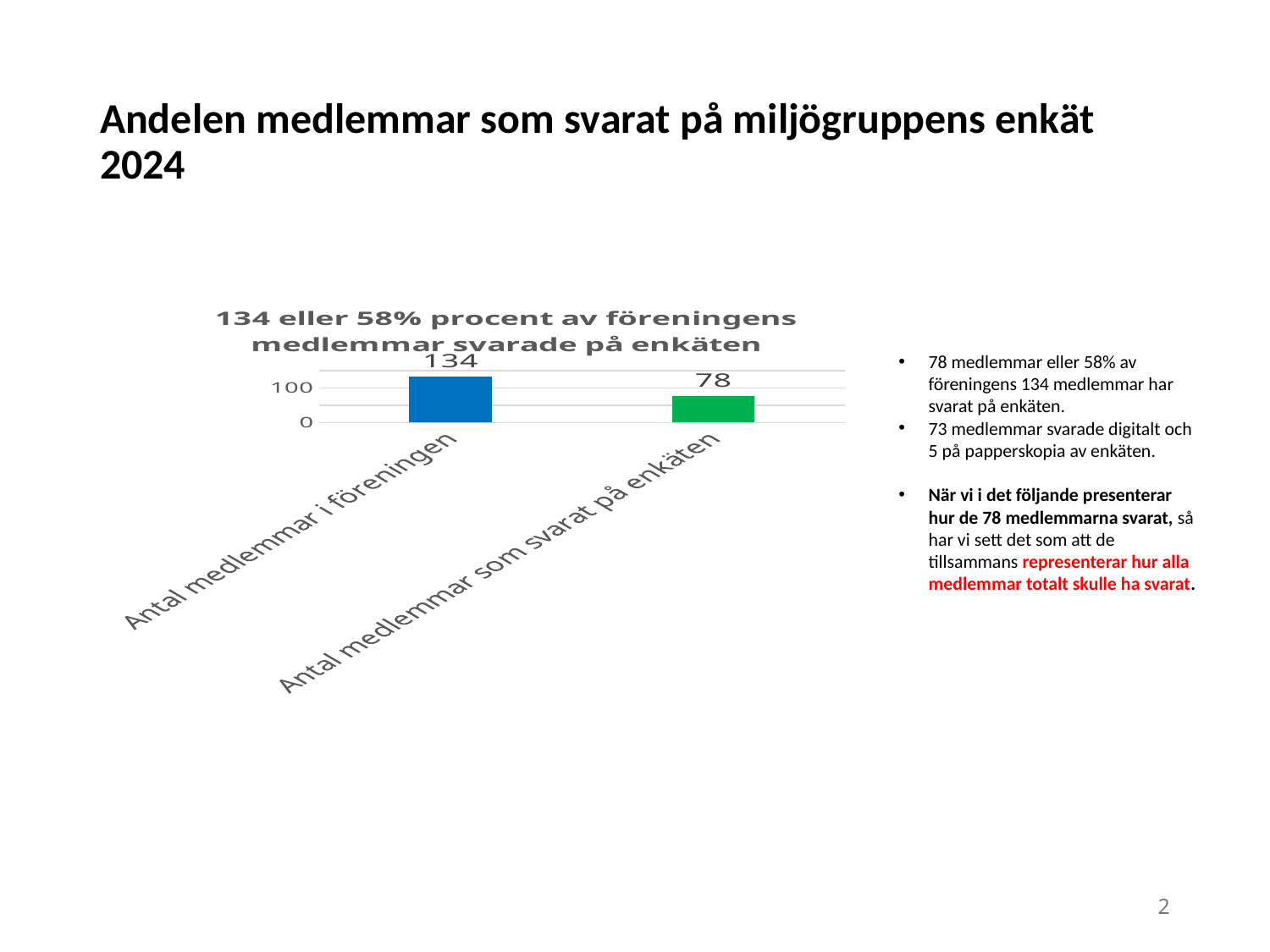
What kind of chart is shown on the slide? bar chart What is the value for "Antal medlemmar som svarat på enkäten"? 78 Is the value for "Antal medlemmar som svarat på enkäten" greater or less than 100? less Which category has the highest value? Antal medlemmar i föreningen What is the title of the chart? 134 eller 58% procent av föreningens medlemmar svarade på enkäten How many categories are shown in the chart? 2 Is the value for "Antal medlemmar i föreningen" greater or less than 100? greater What is the difference between the value for "Antal medlemmar i föreningen" and the value for "Antal medlemmar som svarat på enkäten"? 56 Which is larger: the value for "Antal medlemmar i föreningen" or the value for "Antal medlemmar som svarat på enkäten"? Antal medlemmar i föreningen What colour is the bar for "Antal medlemmar som svarat på enkäten"? green What is the value for "Antal medlemmar i föreningen"? 134 Which category has the lowest value? Antal medlemmar som svarat på enkäten